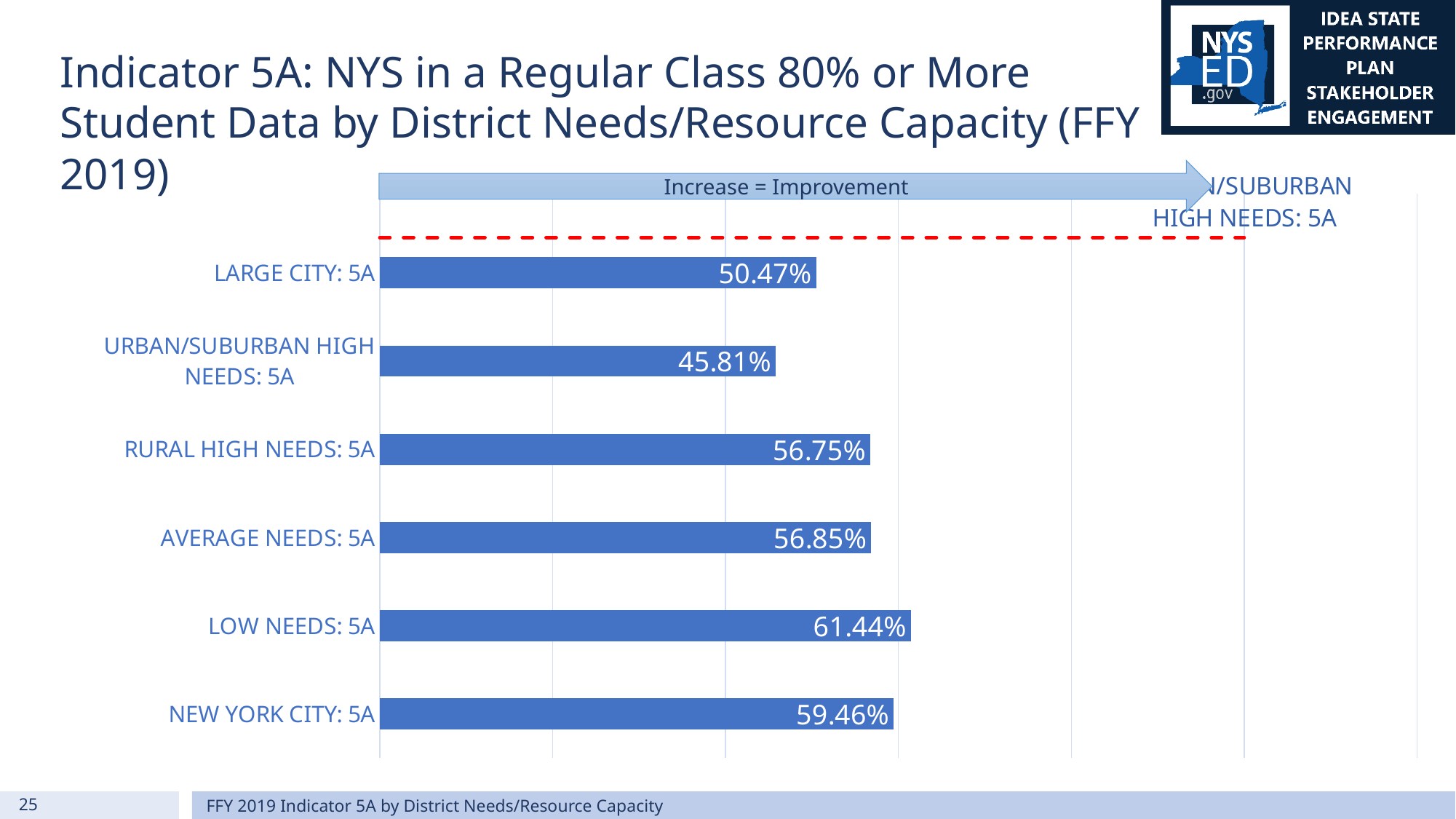
What is the value for NEW YORK CITY: 5A? 59.46% What is the value for URBAN/SUBURBAN HIGH NEEDS: 5A? 45.81% What kind of chart is shown on the slide? Bar chart What is the value for LARGE CITY: 5A? 50.47% What is the value for AVERAGE NEEDS: 5A? 56.85% What is the difference between the values for LARGE CITY: 5A and URBAN/SUBURBAN HIGH NEEDS: 5A? 4.66 percentage points What does the text in the arrow above the chart say? Increase = Improvement Which category has the highest value? LOW NEEDS: 5A Which category has the lowest value? URBAN/SUBURBAN HIGH NEEDS: 5A Which is larger, the value for NEW YORK CITY: 5A or RURAL HIGH NEEDS: 5A? NEW YORK CITY: 5A What is the difference between the values for LOW NEEDS: 5A and NEW YORK CITY: 5A? 1.98 percentage points How many categories are shown in the chart? 6